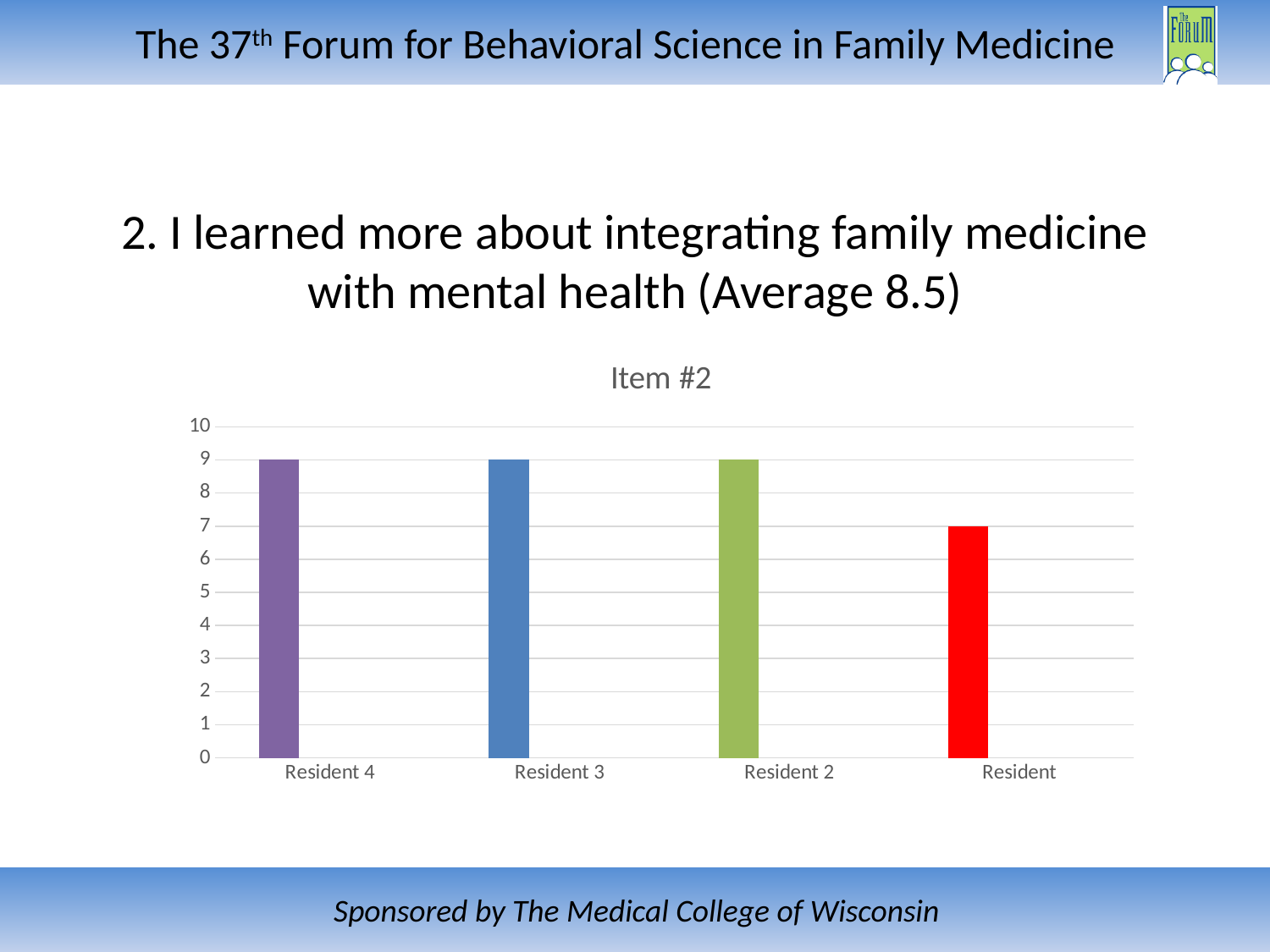
What is the value for Resident 3 in the Item #2 chart? 9 What is the maximum value shown on the vertical axis of the Item #2 chart? 10 What is the value for Resident 4 in the Item #2 chart? 9 What is the value for the category labelled Resident in the Item #2 chart? 7 How many categories are shown in the Item #2 chart? 4 Which has a larger value in the Item #2 chart, Resident 2 or Resident? Resident 2 What is the value for Resident 2 in the Item #2 chart? 9 Which category has the lowest value in the Item #2 chart? Resident What is the difference between the values for Resident 4 and Resident in the Item #2 chart? 2 What kind of chart is shown on the slide? Bar chart What is the title of the chart on the slide? Item #2 Is the value for Resident in the Item #2 chart greater or less than 8? less